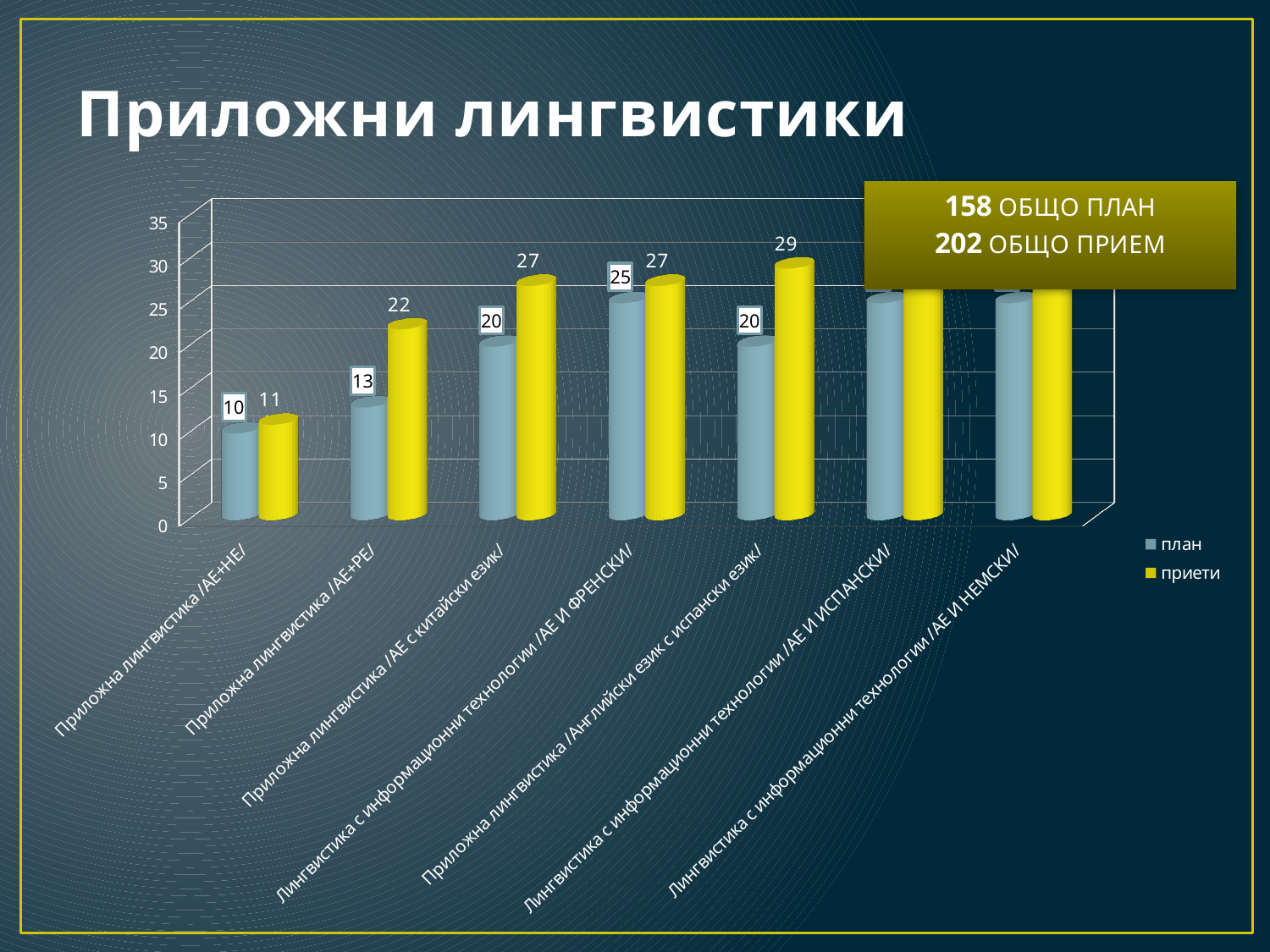
How many categories are shown on the x axis of the chart? 7 Which category has the lowest план value? Приложна лингвистика /АЕ+НЕ/ What is the приети value for Приложна лингвистика /Английски език с испански език/? 29 How many series does the legend list? 2 What total план figure is shown in the box on the slide? 158 Is the план value for Лингвистика с информационни технологии /АЕ И НЕМСКИ/ greater or less than 20? greater What is the план value for Лингвистика с информационни технологии /АЕ И ФРЕНСКИ/? 25 What is the difference between приети and план for Приложна лингвистика /АЕ с китайски език/? 7 Which is larger for Приложна лингвистика /АЕ+РЕ/: план or приети? приети What kind of chart is shown on the slide? bar chart What is the план value for Приложна лингвистика /АЕ+НЕ/? 10 What is the приети value for Приложна лингвистика /АЕ+РЕ/? 22